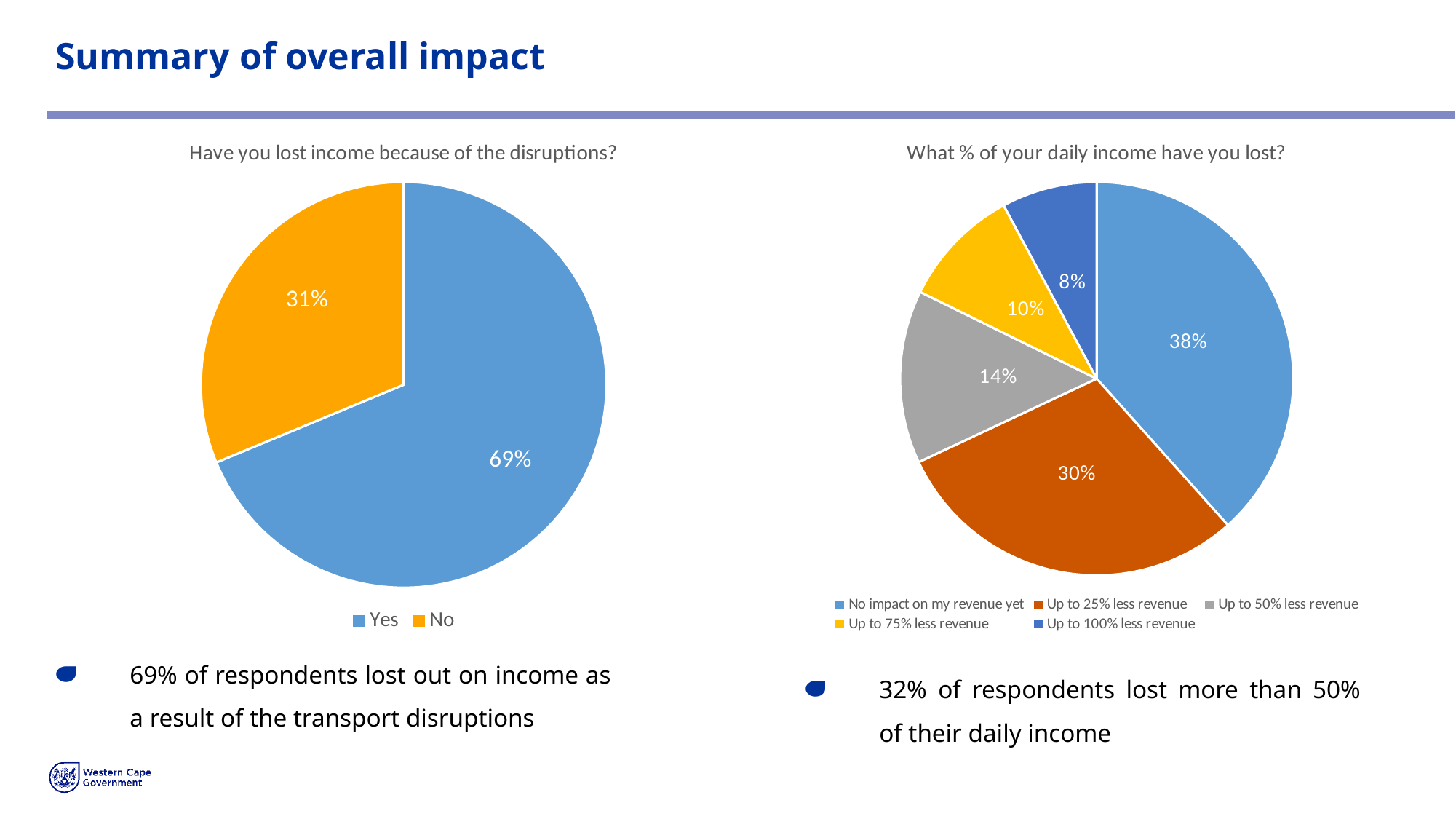
In the chart titled "What % of your daily income have you lost?", which is larger: "Up to 75% less revenue" or "Up to 50% less revenue"? Up to 50% less revenue In the chart titled "What % of your daily income have you lost?", which category has the largest slice? No impact on my revenue yet In the chart titled "What % of your daily income have you lost?", what share is labelled for "Up to 100% less revenue"? 8% What kind of chart is the chart titled "Have you lost income because of the disruptions?"? Pie chart In the chart titled "Have you lost income because of the disruptions?", what share of respondents answered No? 31% In the chart titled "What % of your daily income have you lost?", what share is labelled for "Up to 50% less revenue"? 14% In the chart titled "What % of your daily income have you lost?", what share is labelled for "Up to 25% less revenue"? 30% In the chart titled "What % of your daily income have you lost?", which category has the smallest slice? Up to 100% less revenue In the chart titled "What % of your daily income have you lost?", how many categories does the legend list? 5 In the chart titled "Have you lost income because of the disruptions?", what is the difference between the Yes and No shares? 38% In the chart titled "Have you lost income because of the disruptions?", what share of respondents answered Yes? 69% In the chart titled "What % of your daily income have you lost?", what is the difference between the "No impact on my revenue yet" and "Up to 25% less revenue" shares? 8%